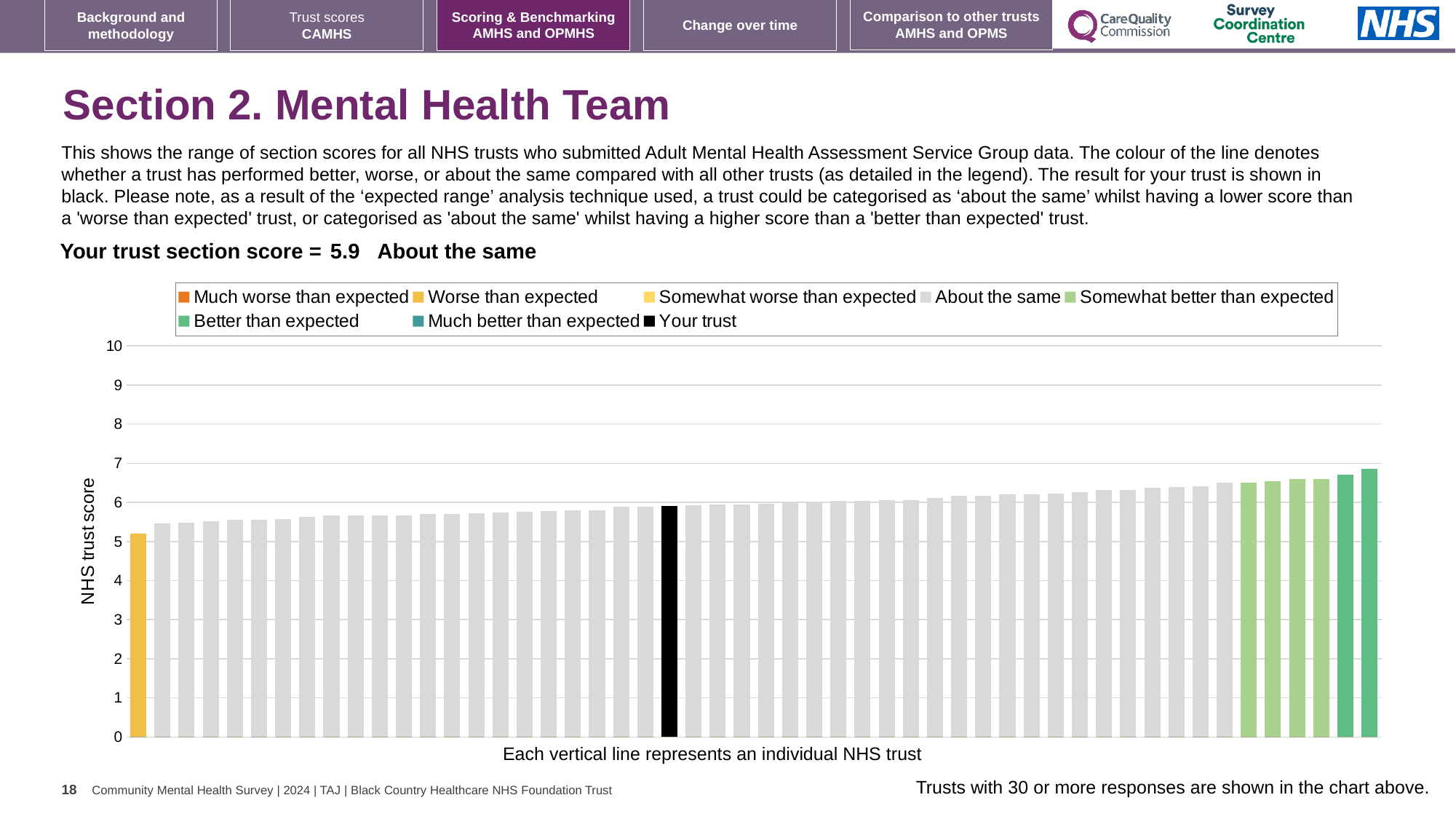
Which benchmarking category is your trust's section score placed in? About the same Is the value for the leftmost bar greater or less than 6? less How many entries does the chart legend list? 8 Is the value for the rightmost bar greater or less than 6? greater What is the section score for your trust? 5.9 Which is higher, the black bar for your trust or the leftmost bar? the black bar for your trust What kind of chart is shown on the slide? bar chart Is the value for your trust greater or less than 6? less Do the bar values rise or fall from left to right along the x axis? rise What colour is the bar representing your trust? black